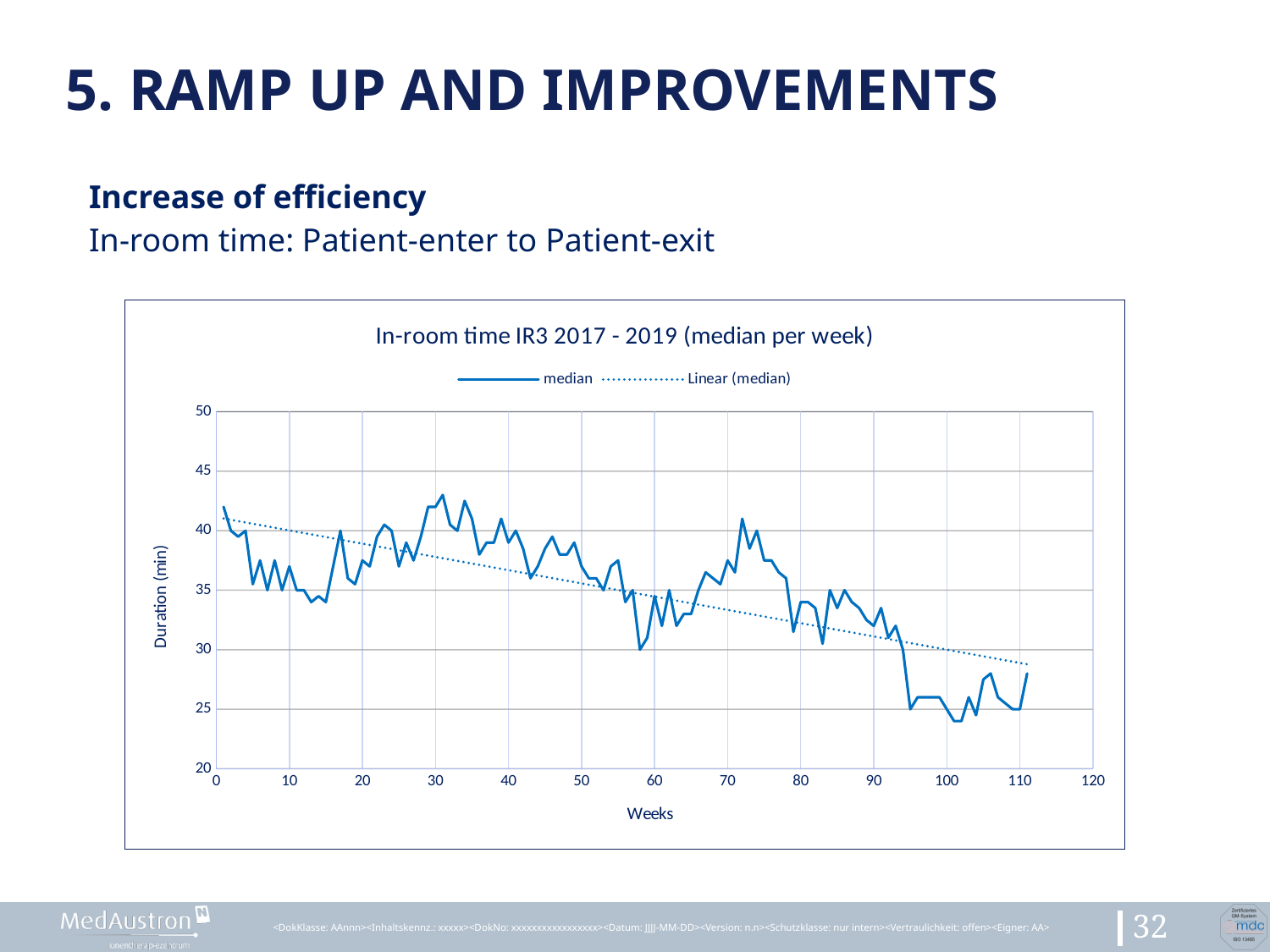
Which is larger, the median value at week 10 or at week 100? week 10 Which is larger, the median value at week 30 or at week 60? week 30 Is the median value at week 80 greater or less than 35? less What are the two entries in the chart legend? median and Linear (median) What kind of chart is shown on the slide? line chart Is the median value at week 100 greater or less than 30? less What is the title of the chart? In-room time IR3 2017 - 2019 (median per week) Is the highest median value on the chart greater or less than 45? less Does the median in-room time generally rise or fall as the weeks increase? fall How many series does the chart legend list? 2